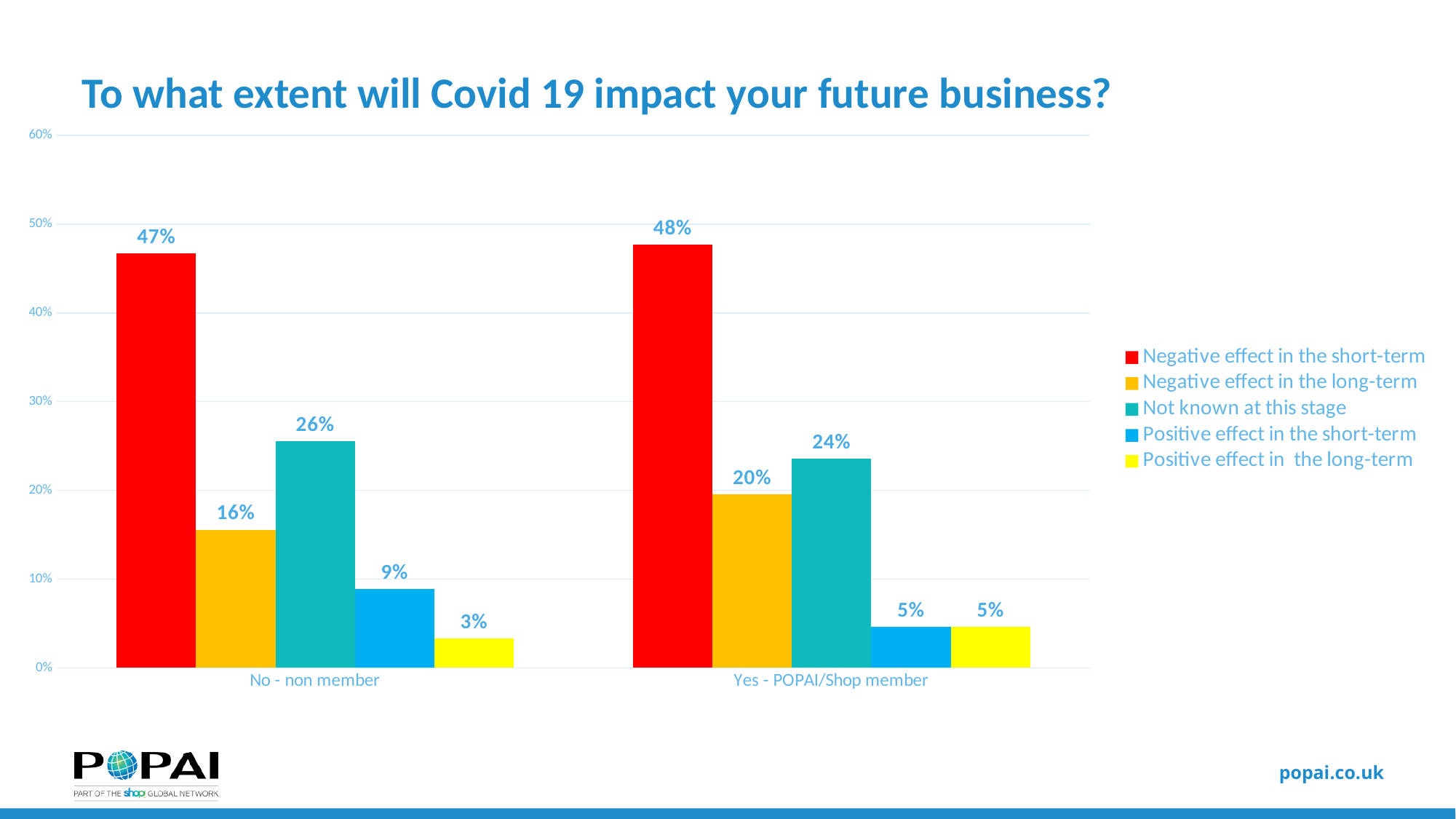
What kind of chart is shown on the slide? Bar chart How many series does the legend list? 5 What is the value for 'Negative effect in the short-term' for 'No - non member'? 47% What is the value for 'Positive effect in the long-term' for 'No - non member'? 3% How many categories are shown on the x axis? 2 What is the title of the chart? To what extent will Covid 19 impact your future business? What is the value for 'Not known at this stage' for 'Yes - POPAI/Shop member'? 24% Which series has the highest value for 'Yes - POPAI/Shop member'? Negative effect in the short-term Which series has the lowest value for 'No - non member'? Positive effect in the long-term Which is larger: 'Positive effect in the short-term' for 'No - non member' or for 'Yes - POPAI/Shop member'? No - non member What is the difference between 'Not known at this stage' for 'No - non member' and for 'Yes - POPAI/Shop member'? 2% What is the value for 'Negative effect in the long-term' for 'Yes - POPAI/Shop member'? 20%